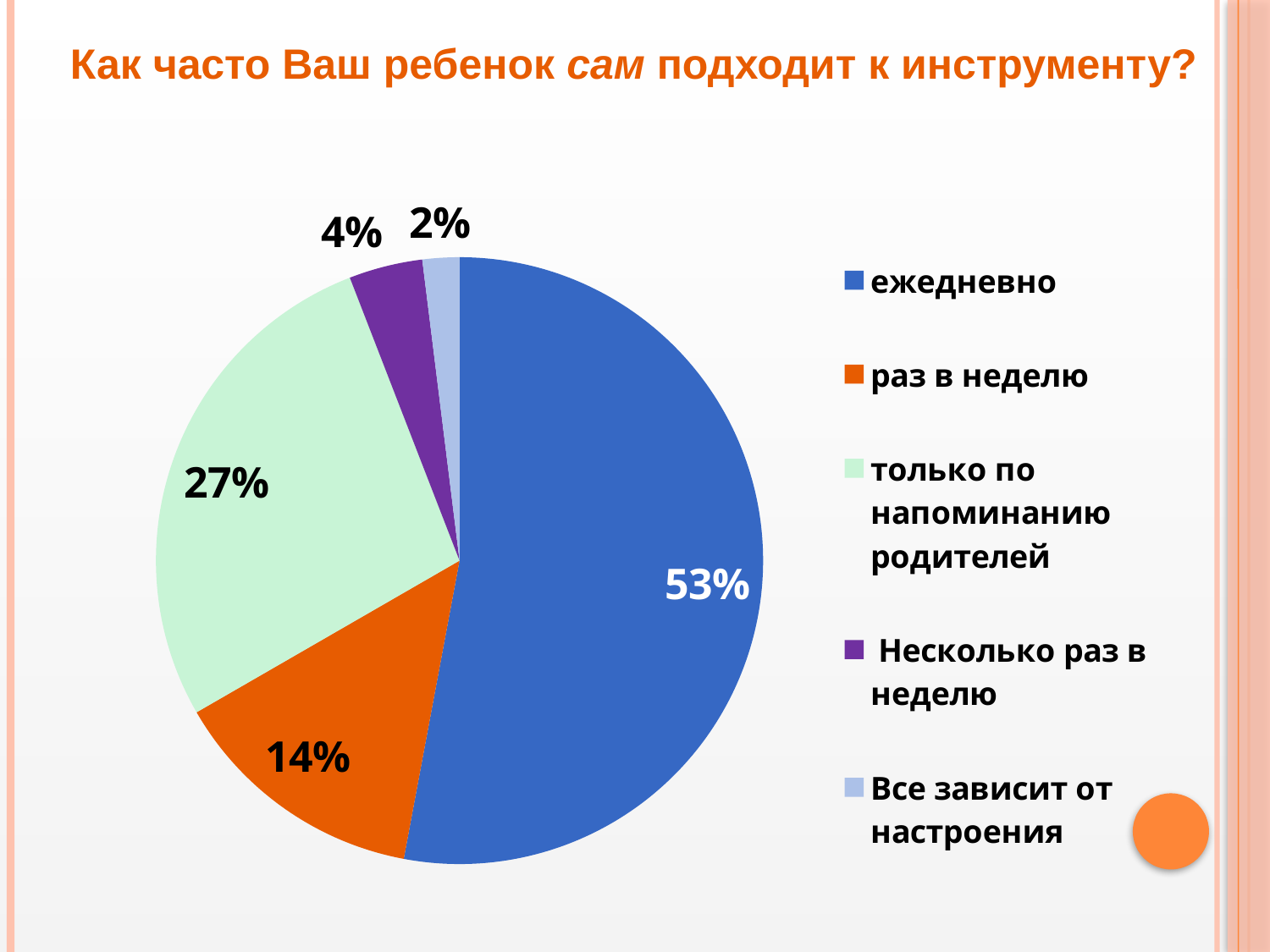
What percentage is shown for "раз в неделю"? 14% Which is larger: the share for "раз в неделю" or the share for "только по напоминанию родителей"? только по напоминанию родителей Which category has the largest share of the pie? ежедневно How many categories does the pie chart have? 5 What percentage is shown for "Все зависит от настроения"? 2% What percentage is shown for "Несколько раз в неделю"? 4% What percentage of the pie corresponds to "ежедневно"? 53% What is the difference in percentage points between "ежедневно" and "только по напоминанию родителей"? 26 What percentage is shown for "только по напоминанию родителей"? 27% What type of chart is shown on the slide? pie chart Which category has the smallest share of the pie? Все зависит от настроения What is the title of the slide? Как часто Ваш ребенок сам подходит к инструменту?